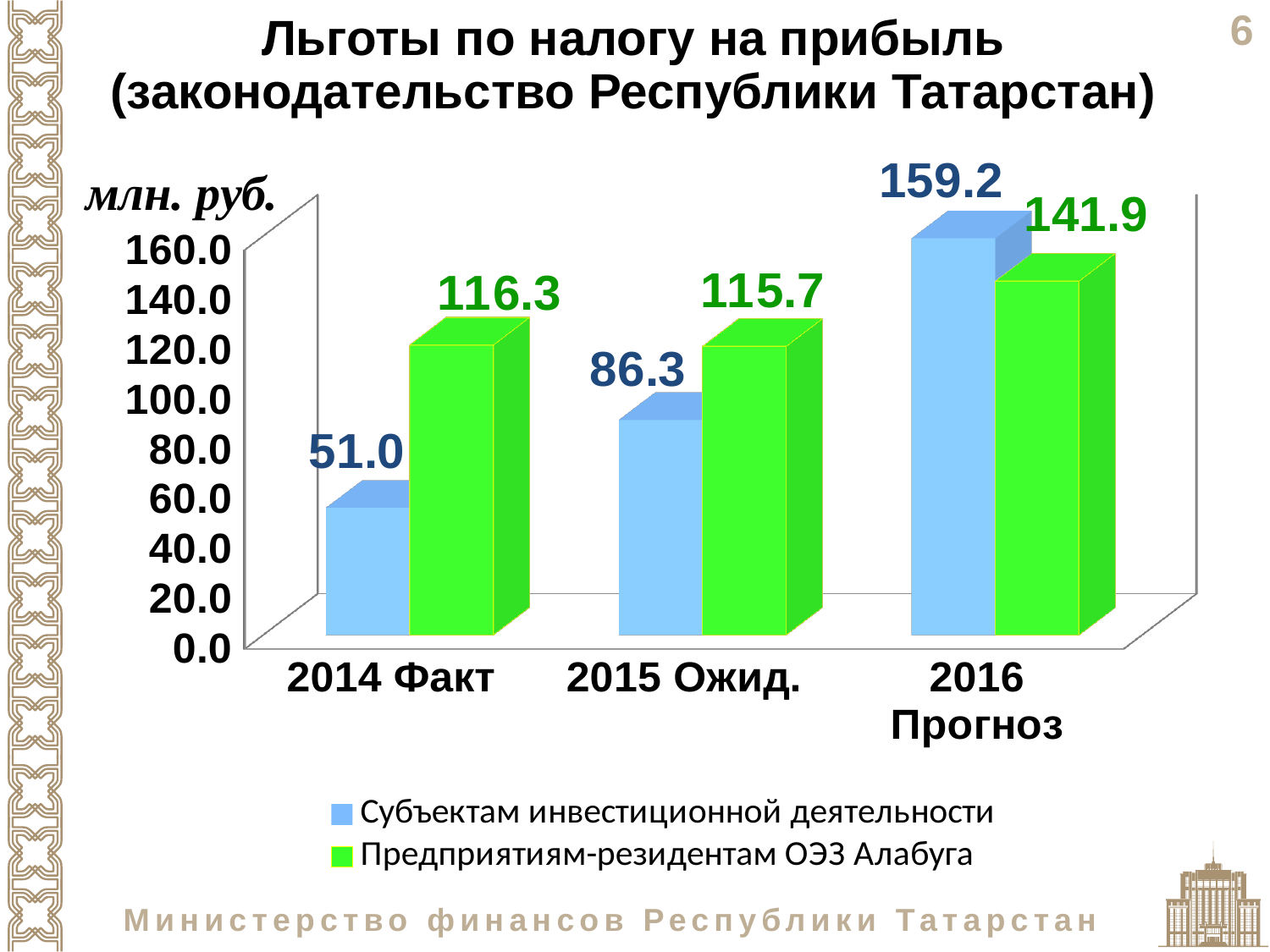
How many periods are shown on the x axis? 3 What is the value for Субъектам инвестиционной деятельности in 2014 Факт? 51.0 Which series has the larger value in 2016 Прогноз? Субъектам инвестиционной деятельности What is the value for Субъектам инвестиционной деятельности in 2016 Прогноз? 159.2 What kind of chart is shown on the slide? Bar chart In which period is the value for Субъектам инвестиционной деятельности highest? 2016 Прогноз What is the value for Предприятиям-резидентам ОЭЗ Алабуга in 2015 Ожид.? 115.7 What is the difference between the two series' values in 2014 Факт? 65.3 Do the values for Субъектам инвестиционной деятельности rise or fall from 2014 Факт to 2016 Прогноз? Rise What unit is indicated above the vertical axis? млн. руб. In which period is the value for Предприятиям-резидентам ОЭЗ Алабуга lowest? 2015 Ожид. How many series does the legend list? 2